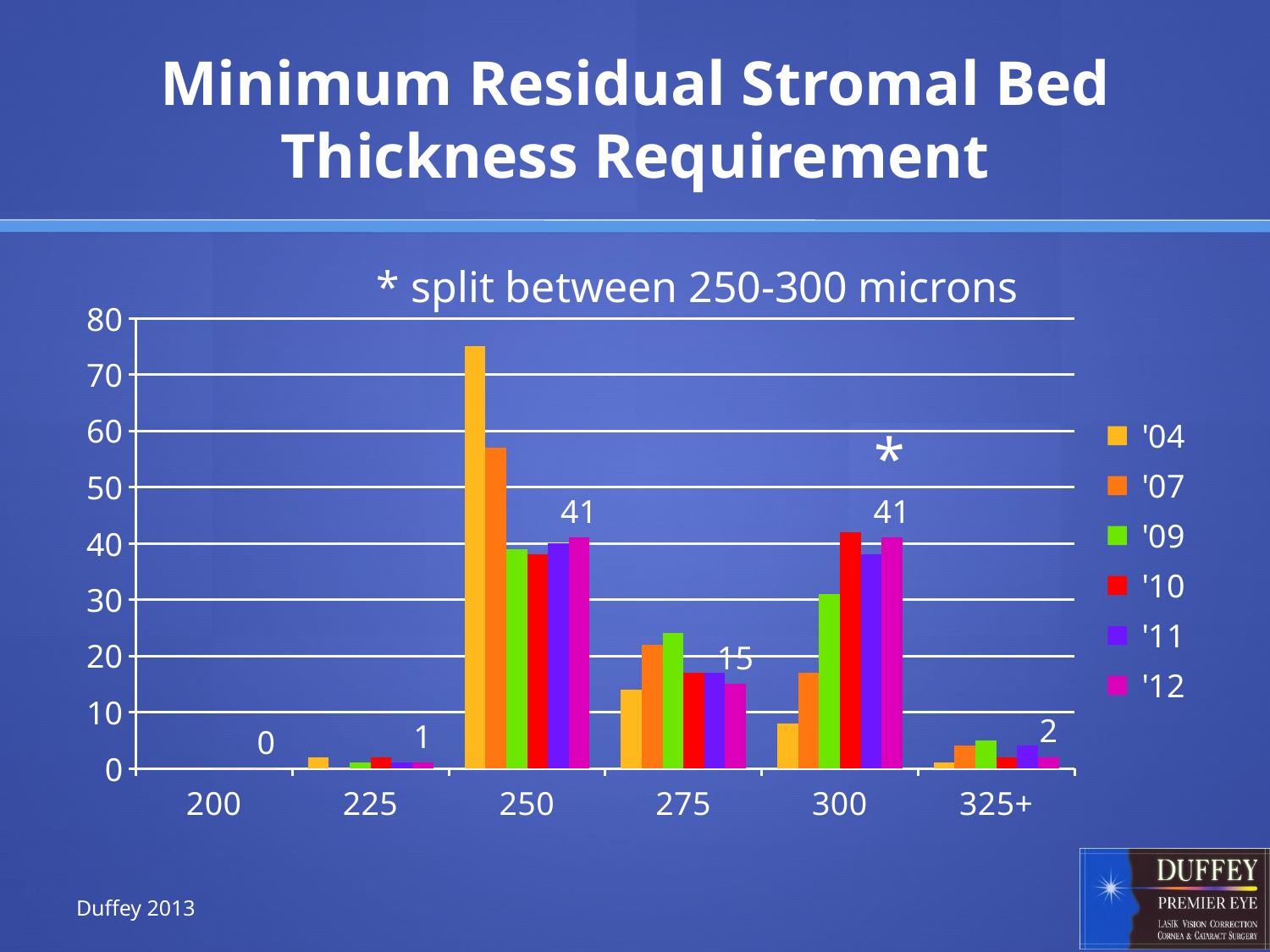
What is the value for '12 at 325+? 2 What kind of chart is shown on the slide? bar chart What is the value for '12 at 225? 1 Which category has the tallest bar in the chart? 250 What is the difference between the '12 values at 250 and 275? 26 Is the value for '04 at 250 greater or less than 70? greater How many series does the legend list? 6 What is the value for '12 at 275? 15 How many categories are shown on the x axis? 6 What is the title of the slide? Minimum Residual Stromal Bed Thickness Requirement What is the value for '12 at 250? 41 Which is larger at 300: the value for '04 or the value for '10? '10